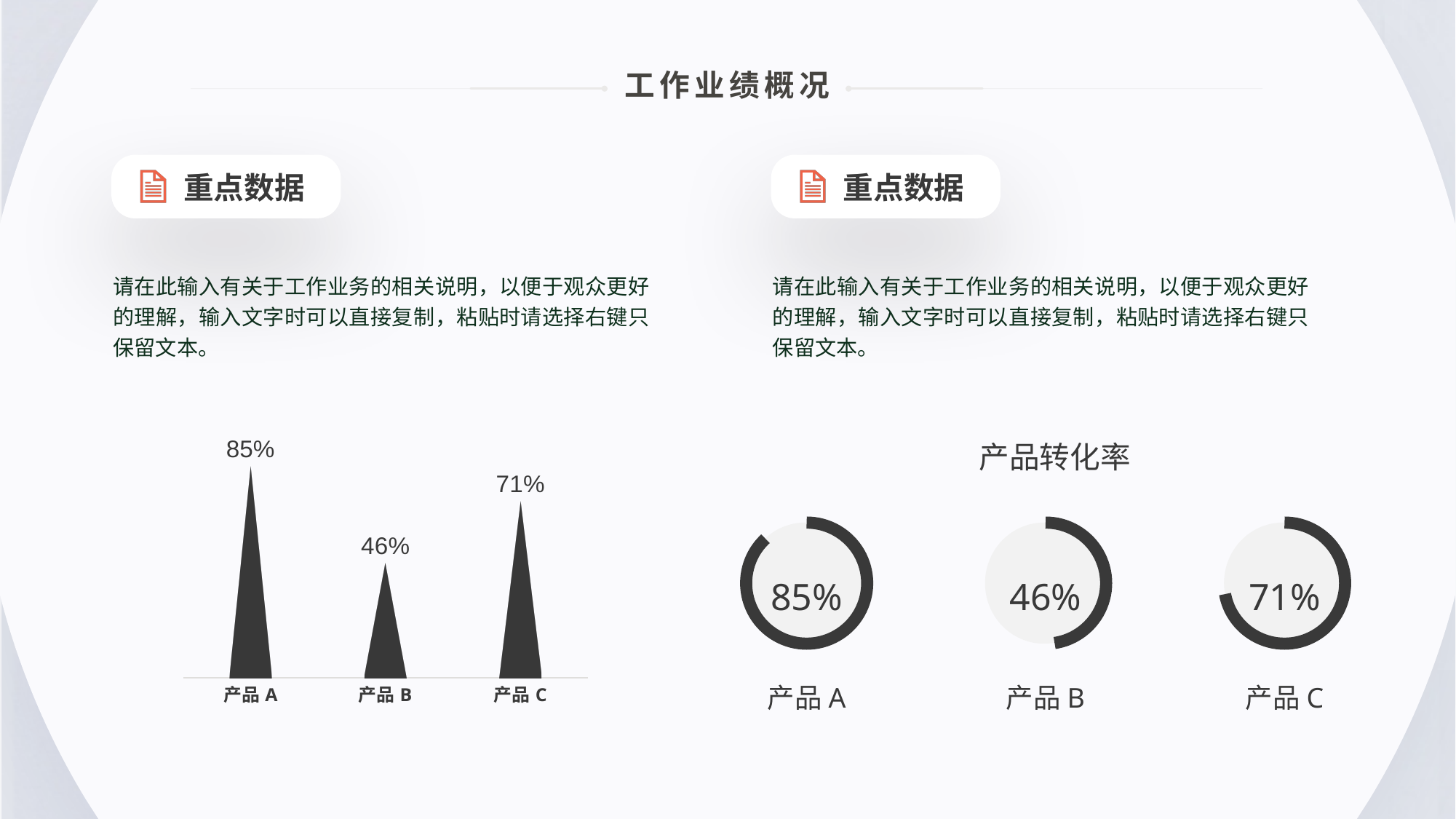
In the bar chart on the left, what is the value for 产品 B? 46% How many categories are shown in the bar chart on the left? 3 What is the title of the group of ring charts on the right side of the slide? 产品转化率 In the 产品转化率 charts on the right, what is the value shown for 产品 B? 46% In the 产品转化率 charts on the right, what is the difference between the values for 产品 C and 产品 B? 25% In the bar chart on the left, what is the value for 产品 C? 71% What kind of chart is shown on the left side of the slide? Bar chart In the bar chart on the left, which is larger, the value for 产品 B or 产品 C? 产品 C In the bar chart on the left, what is the difference between the values for 产品 A and 产品 C? 14% In the bar chart on the left, which category has the lowest value? 产品 B In the bar chart on the left, what is the value for 产品 A? 85% In the bar chart on the left, which category has the highest value? 产品 A